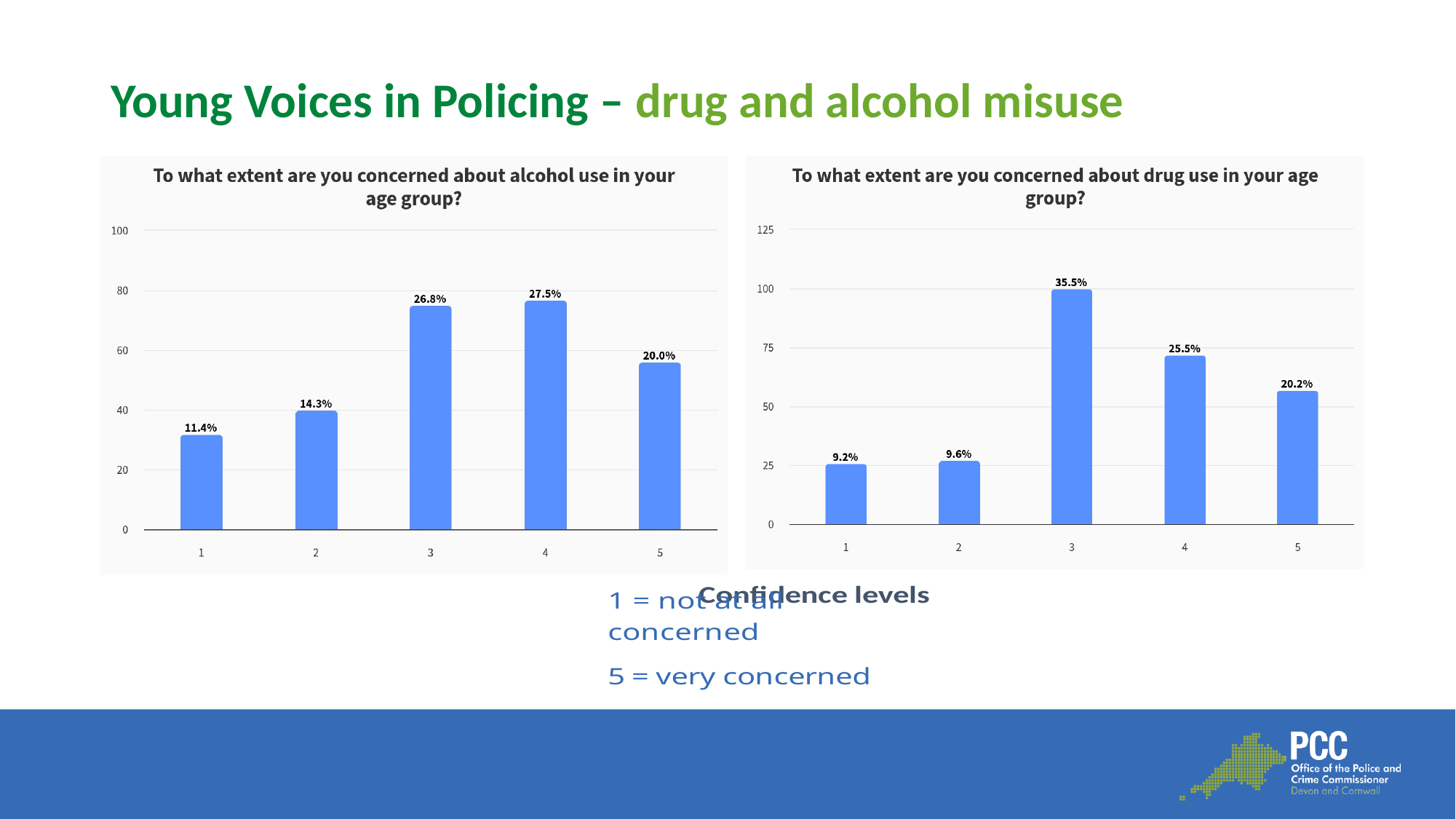
How many categories are shown on the x axis of the drug use chart on the right? 5 In the chart titled "To what extent are you concerned about drug use in your age group?", what is the data label on the bar for category 3? 35.5% In the alcohol use chart on the left, what is the difference in percentage points between the labels for category 4 and category 3? 0.7 In the drug use chart on the right, what is the difference in percentage points between the labels for category 3 and category 4? 10.0 In the alcohol use chart on the left, which category has the highest bar? 4 In the drug use chart on the right, which category has the lowest bar? 1 What kind of chart is the alcohol use chart on the left? bar chart In the drug use chart on the right, what is the data label on the bar for category 5? 20.2% In the drug use chart on the right, is the bar for category 2 taller or shorter than the bar for category 4? shorter In the alcohol use chart on the left, is the bar for category 3 greater or less than 60 on the vertical axis? greater In the alcohol use chart on the left, what is the data label on the bar for category 1? 11.4% In the chart titled "To what extent are you concerned about alcohol use in your age group?", what is the data label on the bar for category 4? 27.5%